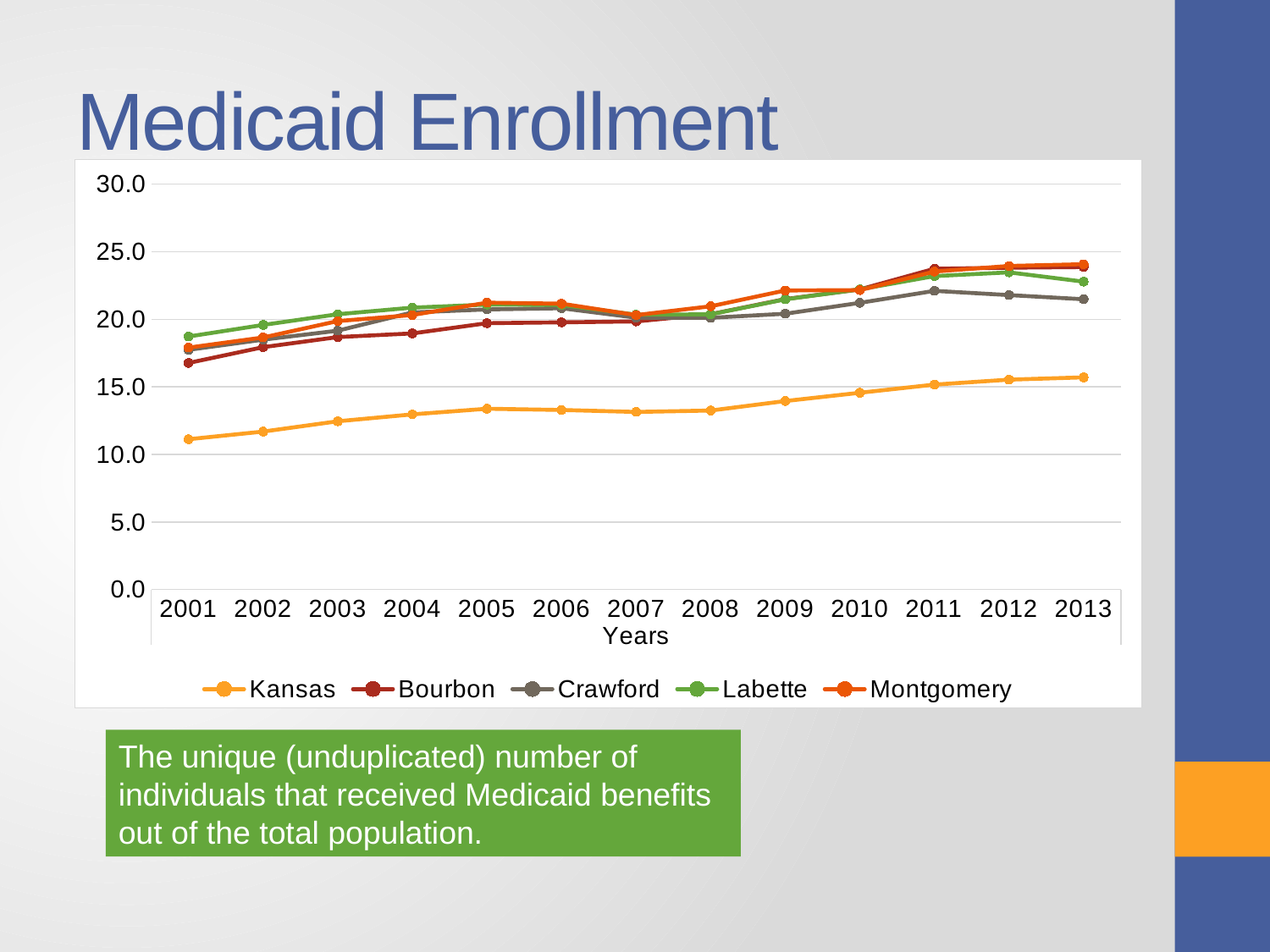
What is the label on the x axis of the chart? Years What kind of chart is shown on the slide? line chart Is the value for Bourbon in 2001 greater or less than 20.0? less Is the value for Kansas in 2001 greater or less than 15.0? less In 2005, which is larger: the value for Kansas or the value for Labette? Labette Which series has the lowest value in 2001? Kansas Which series has the lowest value in 2013? Kansas Is the value for Kansas in 2013 greater or less than 15.0? greater How many years are plotted along the x axis? 13 Does the Kansas line generally rise or fall from 2001 to 2013? rise How many series does the legend list? 5